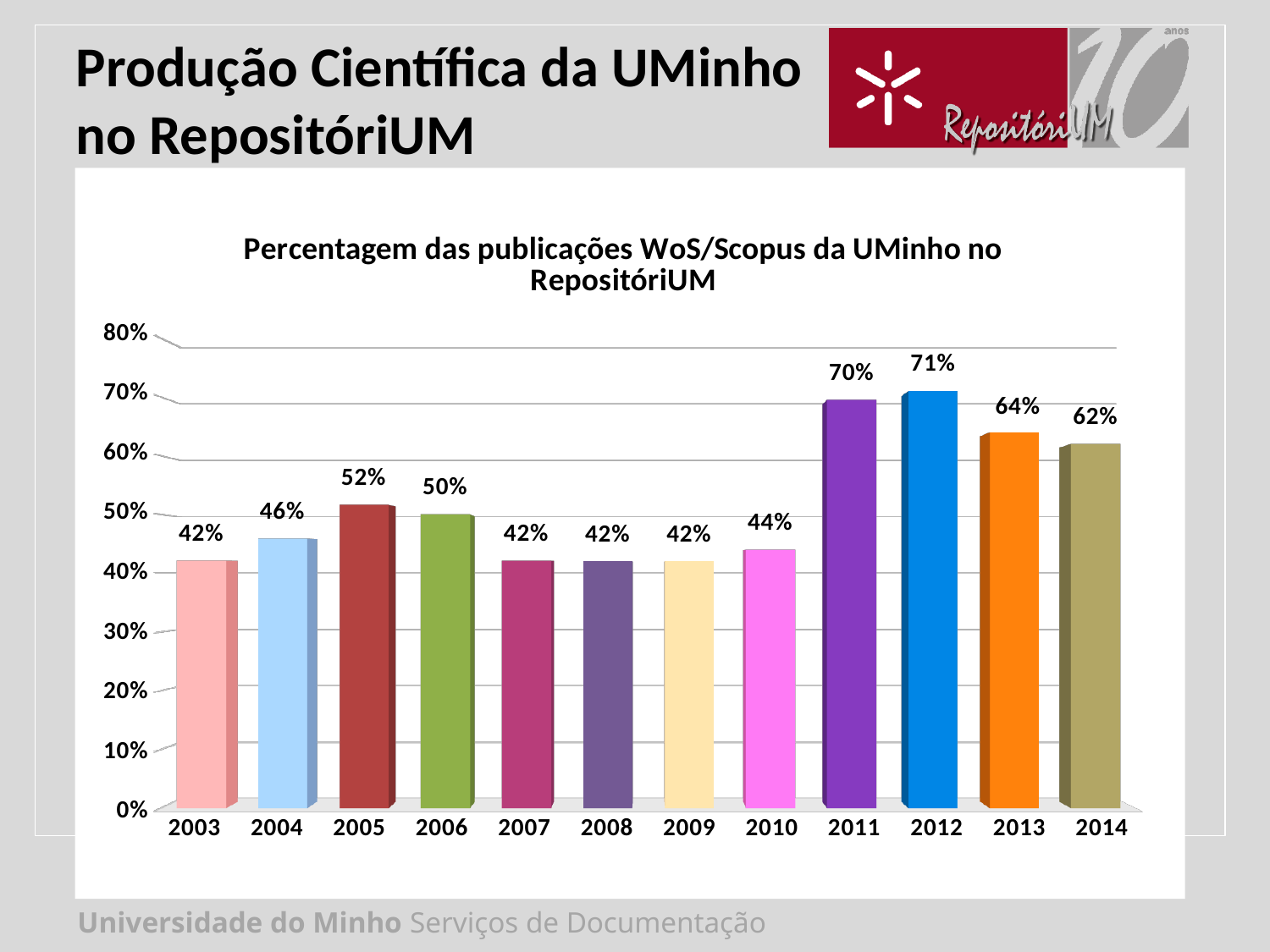
What is the value for 2005? 52% What is the title of the chart? Percentagem das publicações WoS/Scopus da UMinho no RepositóriUM How many years are shown on the x axis? 12 What is the difference between the values for 2012 and 2003? 29% What kind of chart is shown? bar chart Is the value for 2011 greater or less than 60%? greater What is the difference between the values for 2013 and 2014? 2% Which year has the highest value? 2012 Do the values rise or fall from 2010 to 2012? rise What is the value for 2014? 62% Which is larger, the value for 2006 or the value for 2010? 2006 What is the value for 2012? 71%